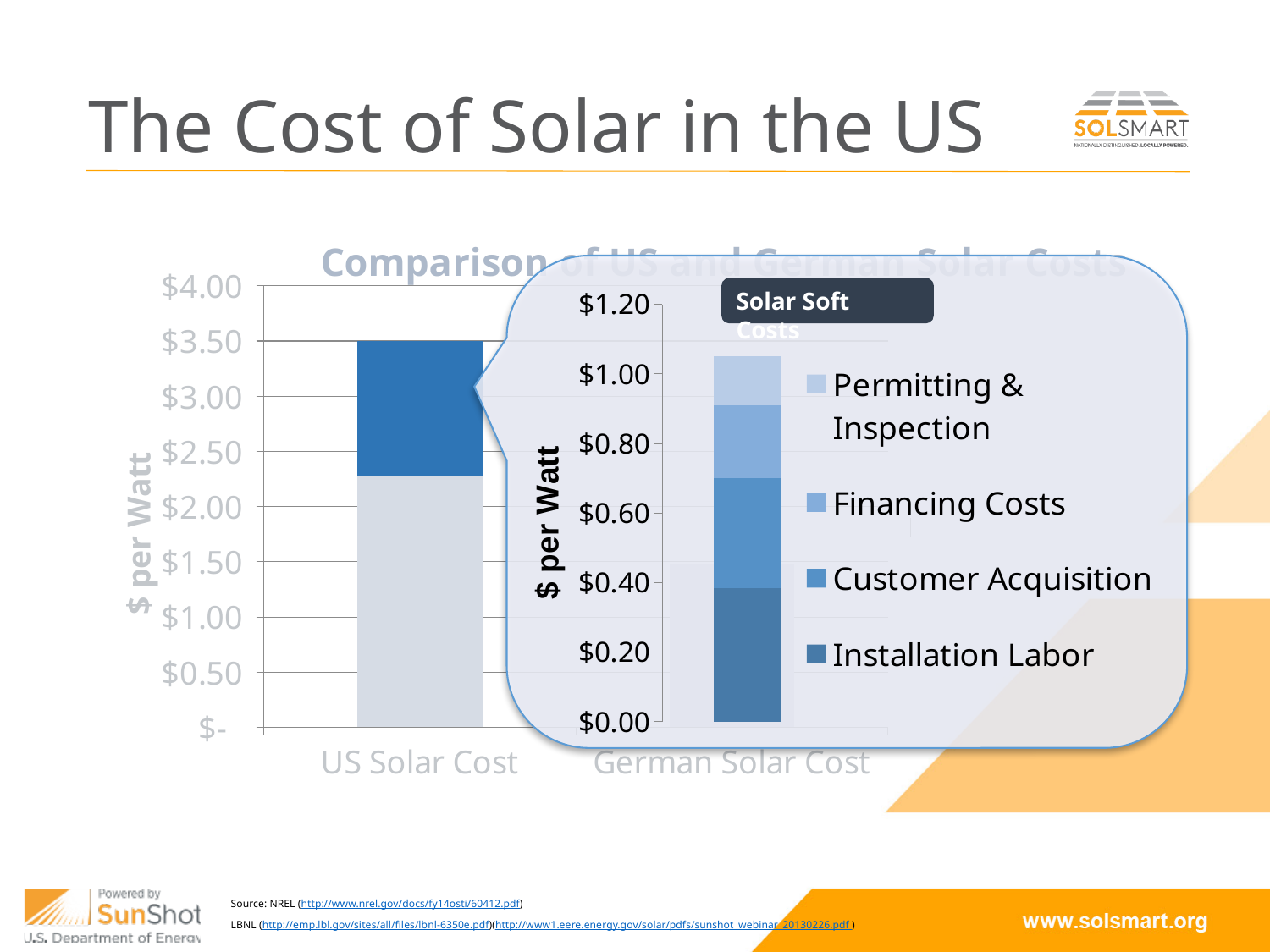
In the Comparison of US and German Solar Costs chart, is the total US Solar Cost greater or less than $3.00? greater What kind of chart is the Comparison of US and German Solar Costs chart? bar chart In the Solar Soft Costs chart, which cost component is the largest segment of the bar? Installation Labor In the Solar Soft Costs chart, is the Installation Labor segment greater or less than $0.60? less In the Solar Soft Costs chart, is the Installation Labor segment larger or smaller than the Financing Costs segment? larger How many categories are shown on the x axis of the Comparison of US and German Solar Costs chart? 2 How many series does the legend of the Solar Soft Costs chart list? 4 What is the y-axis label of the Comparison of US and German Solar Costs chart? $ per Watt In the Solar Soft Costs chart, is the total height of the stacked bar greater or less than $0.80? greater What is the title of the chart shown in the callout box? Solar Soft Costs What kind of chart is the Solar Soft Costs chart in the callout? bar chart